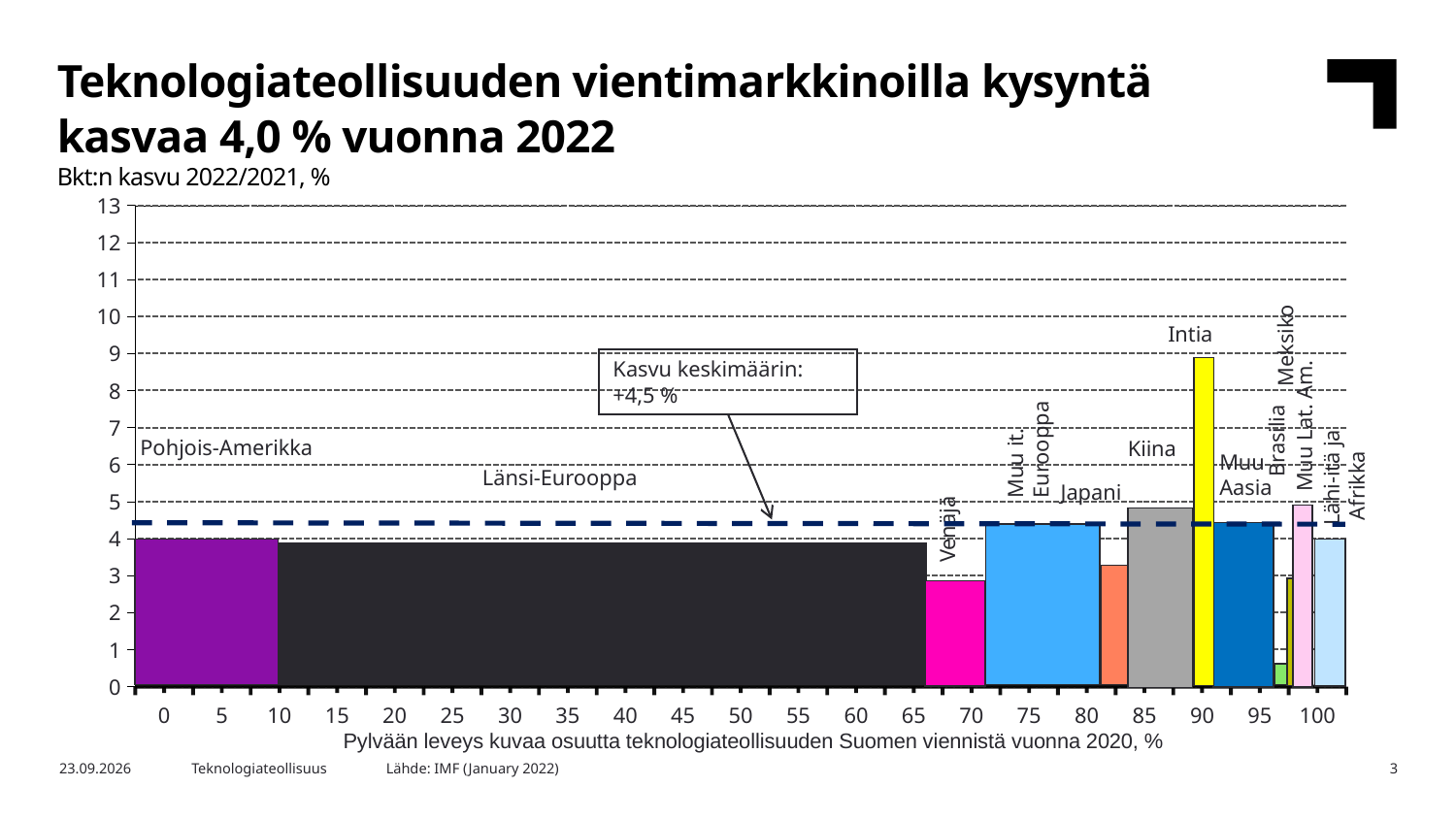
Is the value for Kiina greater or less than 4? greater What average growth value is given in the annotation box on the chart? +4,5 % How many regions (bars) are shown in the chart? 12 Which region has the lowest GDP growth in the chart? Brasilia Which region has the highest GDP growth in the chart? Intia What kind of chart is shown on the slide? bar chart Which has the larger value, Meksiko or Brasilia? Meksiko Is the value for Japani greater or less than 4? less Which has the larger value, Intia or Kiina? Intia Is the value for Intia greater or less than 8? greater